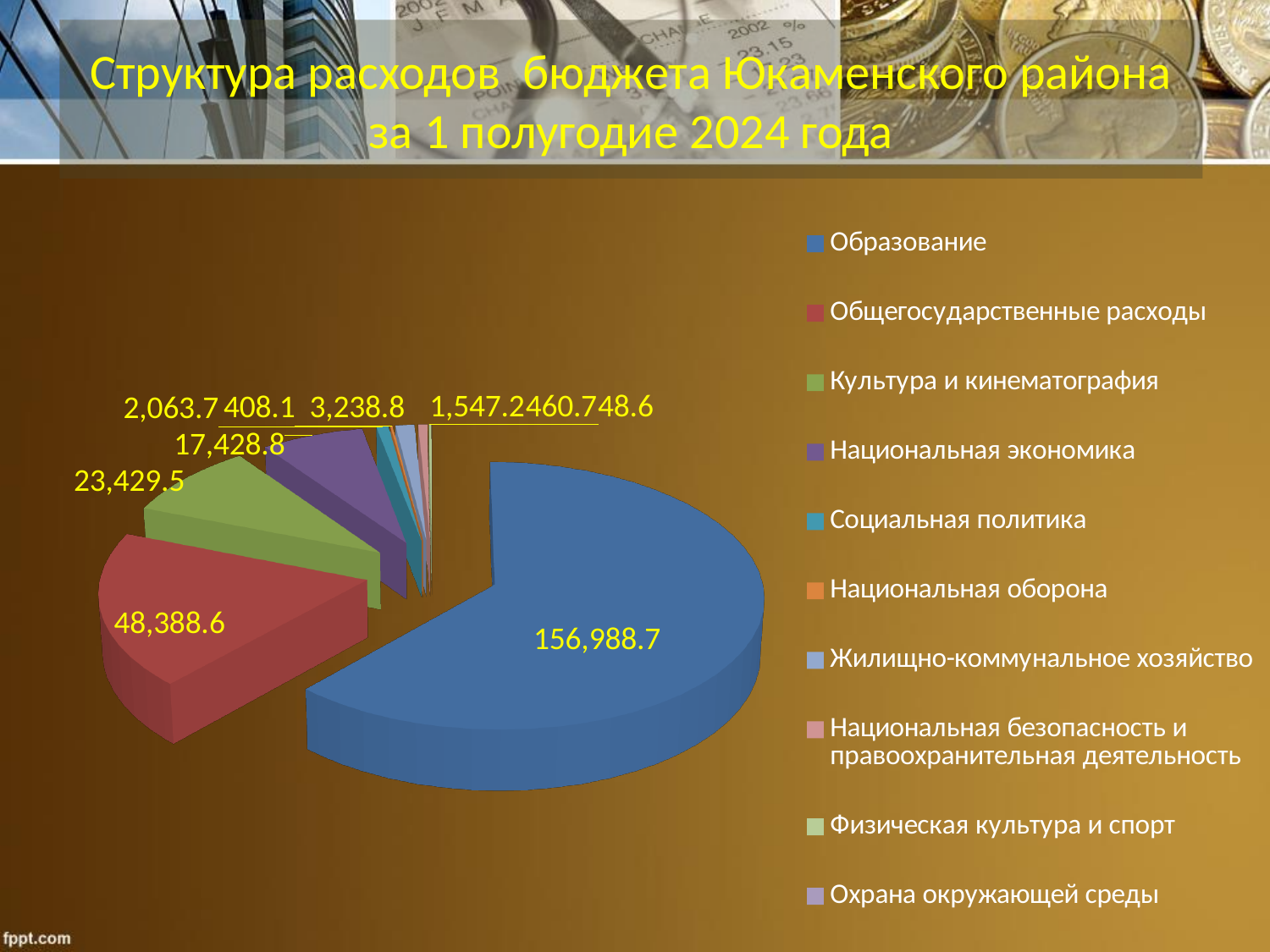
What kind of chart is shown on the slide? pie chart What is the value shown for Общегосударственные расходы? 48,388.6 Which is larger, the value for Культура и кинематография or the value for Национальная экономика? Культура и кинематография What is the difference between the values for Общегосударственные расходы and Культура и кинематография? 24,959.1 What is the value shown for Культура и кинематография? 23,429.5 What is the smallest value labelled on the pie chart? 48.6 What is the difference between the values for Образование and Общегосударственные расходы? 108,600.1 What is the value shown for Образование? 156,988.7 How many categories does the legend list? 10 What is the value shown for Национальная экономика? 17,428.8 Which category has the largest slice of the pie? Образование What colour is the slice for Образование? blue